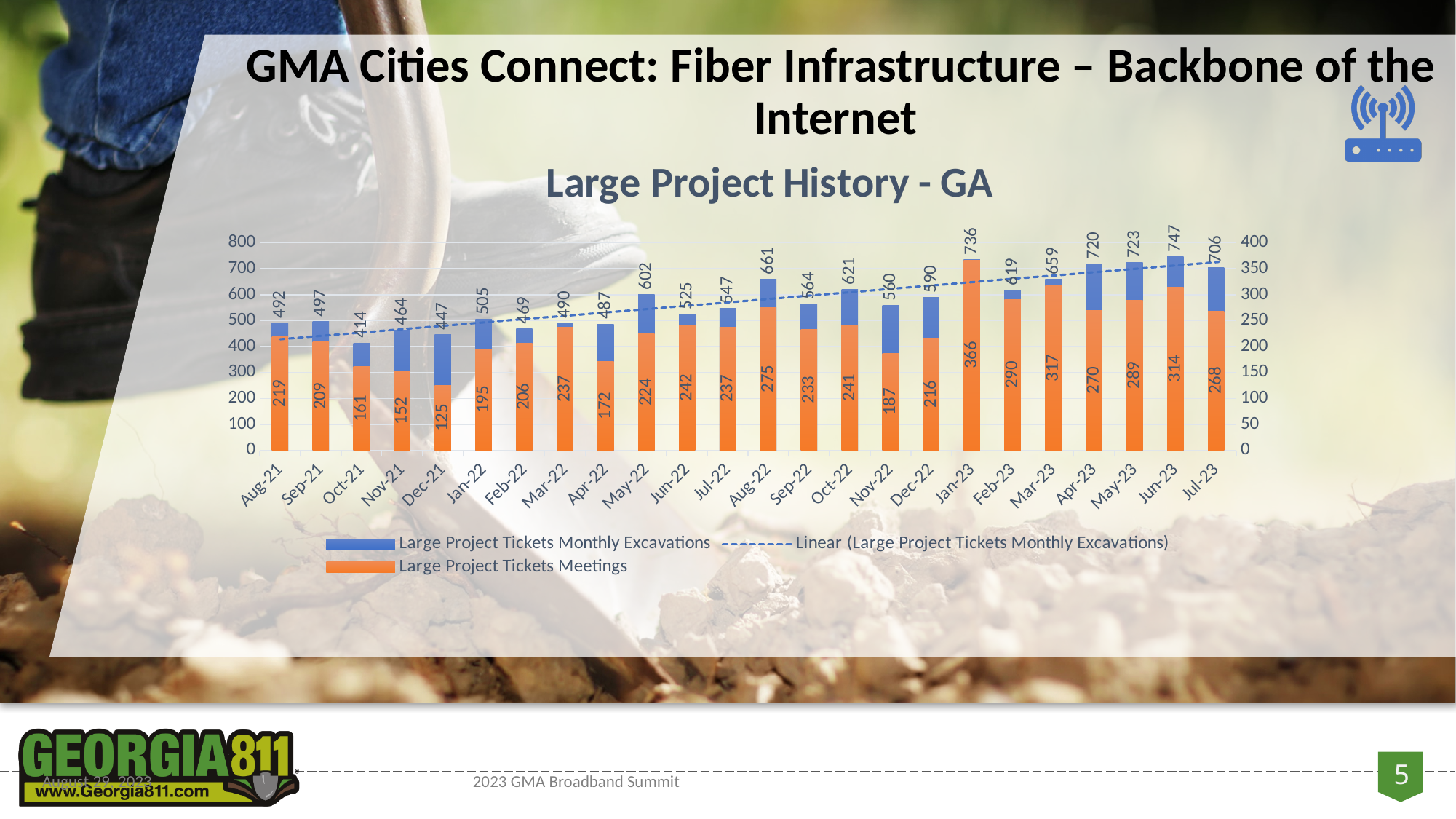
Which is larger, the Large Project Tickets Meetings value for Jun-23 or for Apr-23? Jun-23 What is the value of Large Project Tickets Meetings for Dec-21? 125 What is the title of the chart? Large Project History - GA What kind of chart is shown on the slide? Bar chart What is the difference between the Large Project Tickets Monthly Excavations values for Jun-23 and Aug-21? 255 Which month has the highest value for Large Project Tickets Meetings? Jan-23 What is the value of Large Project Tickets Monthly Excavations for Aug-21? 492 What is the value of Large Project Tickets Monthly Excavations for Jan-23? 736 Which month has the highest value for Large Project Tickets Monthly Excavations? Jun-23 How many months are shown on the x axis of the chart? 24 Which month has the lowest value for Large Project Tickets Monthly Excavations? Oct-21 How many entries does the chart legend list? 3